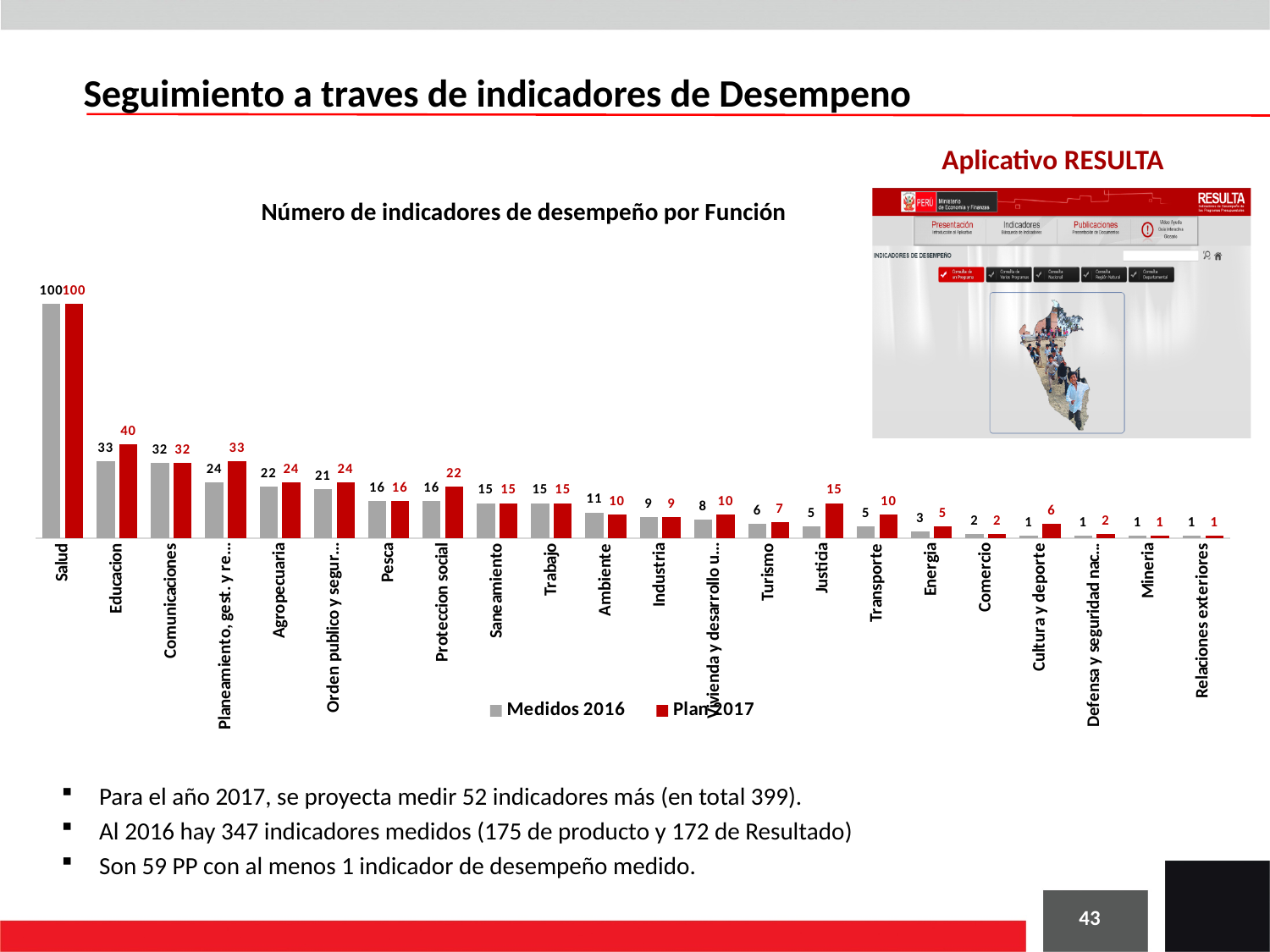
What is the Plan 2017 value for Educacion? 40 How many functions (categories) are shown on the x axis of the chart? 22 What is the Plan 2017 value for Proteccion social? 22 What is the title of the chart? Número de indicadores de desempeño por Función Which is larger for Ambiente: the Medidos 2016 value or the Plan 2017 value? Medidos 2016 Which is larger for Cultura y deporte: the Medidos 2016 value or the Plan 2017 value? Plan 2017 How many series does the chart legend list? 2 Which function has the highest Medidos 2016 value? Salud What is the difference between the Plan 2017 and Medidos 2016 values for Educacion? 7 What type of chart is used to show the number of performance indicators by function? Bar chart What is the Medidos 2016 value for Justicia? 5 What is the difference between the Plan 2017 and Medidos 2016 values for Justicia? 10